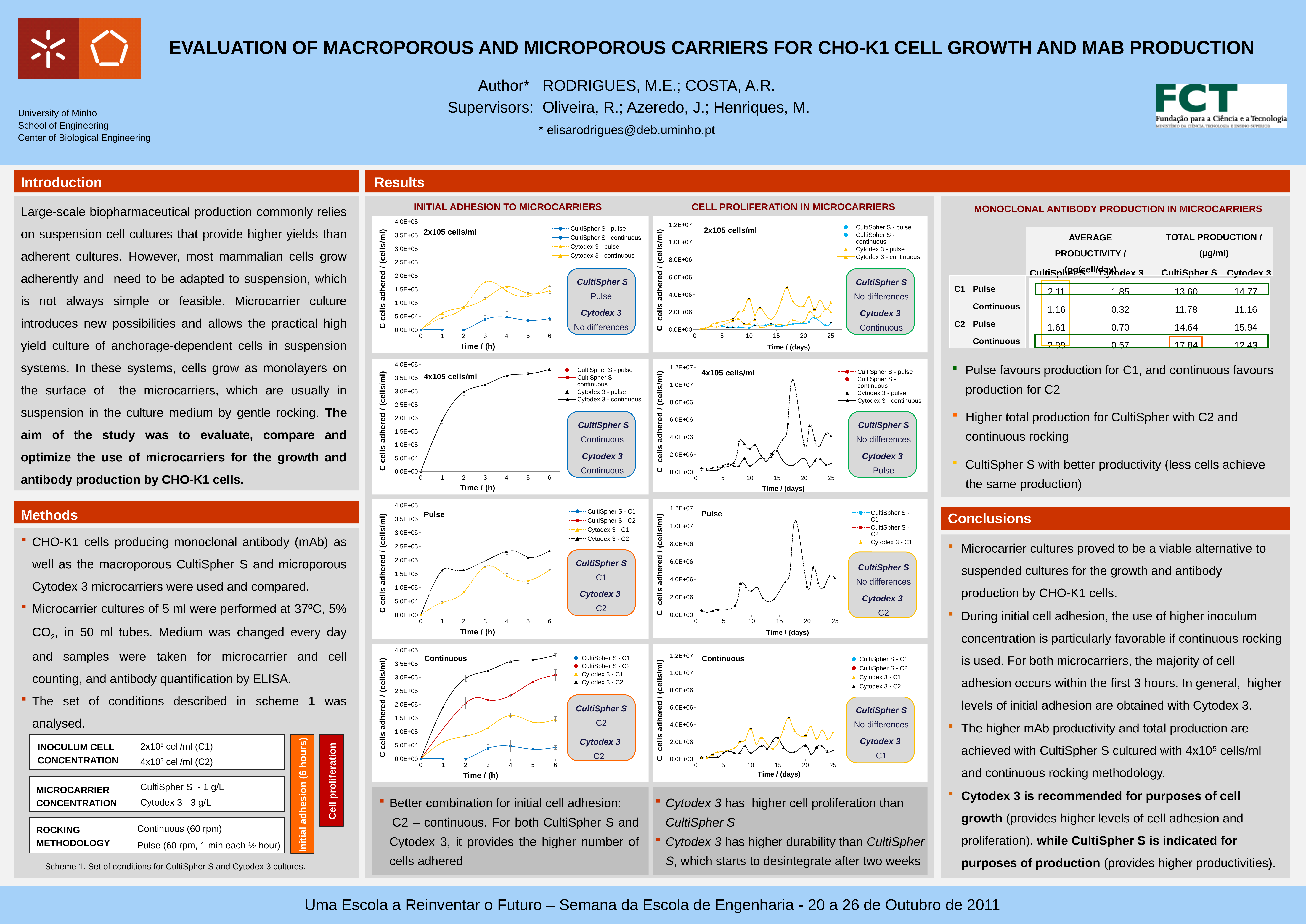
How many series does the legend list in the '2x105 cells/ml' chart under Initial Adhesion to Microcarriers? 4 How many series does the legend list in the 'Pulse' chart under Cell Proliferation in Microcarriers? 3 In the '4x105 cells/ml' chart under Cell Proliferation in Microcarriers, is the peak value of the Cytodex 3 - pulse series greater or less than 8.0E+06? greater In the '4x105 cells/ml' chart under Initial Adhesion to Microcarriers, does the Cytodex 3 - continuous series rise or fall over time? rise What kind of chart is the 'Continuous' chart in the Initial Adhesion to Microcarriers column? line chart What is the x-axis label of the charts in the Cell Proliferation in Microcarriers column? Time / (days) In the 'Continuous' chart under Initial Adhesion to Microcarriers, which series is higher at 6 h: Cytodex 3 - C2 or CultiSpher S - C1? Cytodex 3 - C2 In the '2x105 cells/ml' chart under Initial Adhesion to Microcarriers, is the value for CultiSpher S - continuous at 6 h greater or less than 1.0E+05? less In the 'Continuous' chart under Cell Proliferation in Microcarriers, which series reaches the highest value: Cytodex 3 - C1 or CultiSpher S - C1? Cytodex 3 - C1 What is the maximum value shown on the y-axis of the charts in the Initial Adhesion to Microcarriers column? 4.0E+05 In the 'Continuous' chart under Initial Adhesion to Microcarriers, is the value for Cytodex 3 - C2 at 6 h greater or less than 3.0E+05? greater